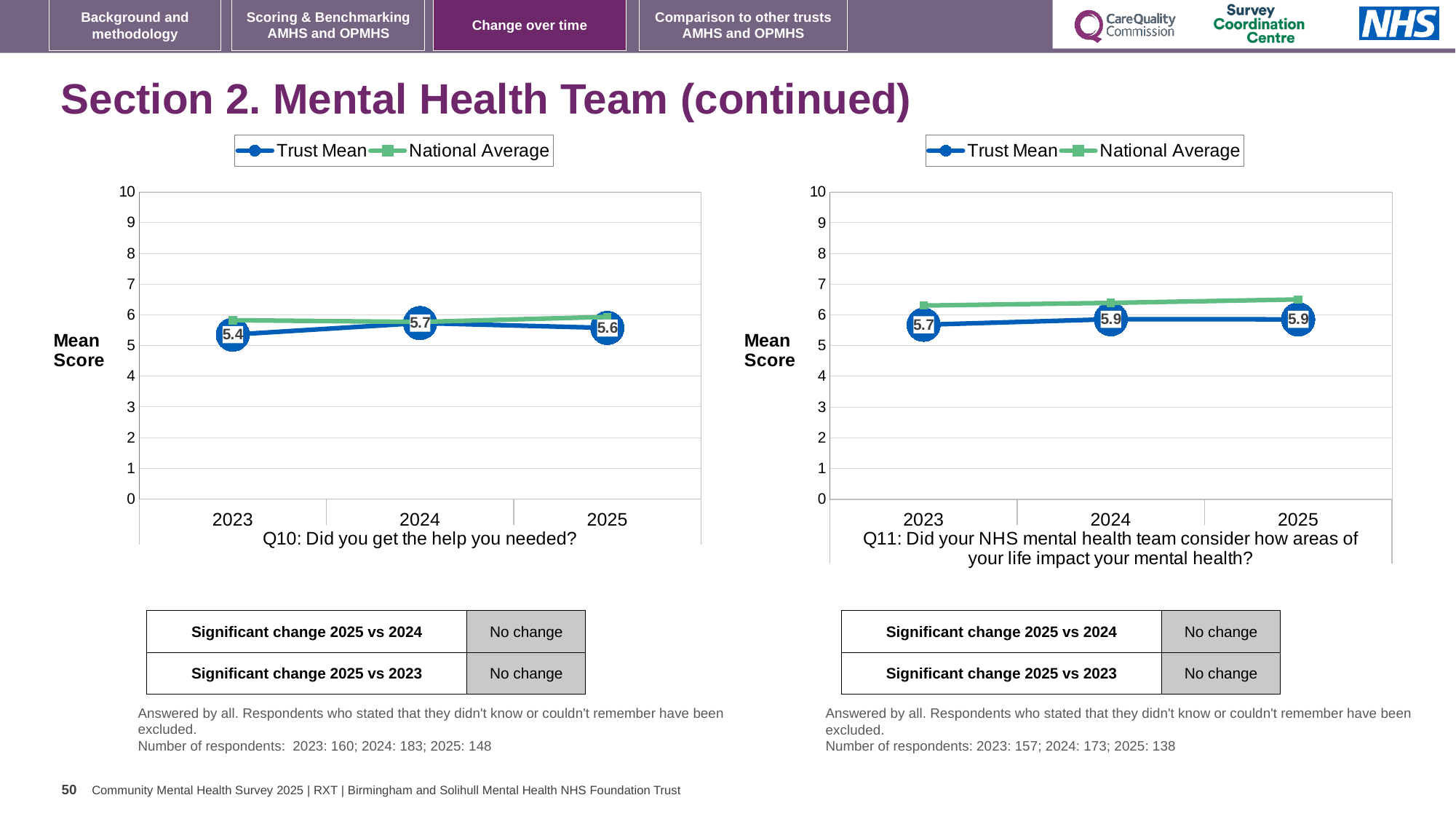
What type of chart is used for Q11? Line chart In the Q11 chart, which year has the lowest Trust Mean? 2023 In the Q10 chart, what is the Trust Mean for 2025? 5.6 In the Q11 chart, what is the Trust Mean for 2024? 5.9 In the Q10 chart, is the Trust Mean higher in 2023 or 2025? 2025 In the Q10 chart, which year has the highest Trust Mean? 2024 How many years are plotted on the x axis of the Q11 chart? 3 In the Q11 chart, what is the difference between the Trust Mean for 2025 and 2023? 0.2 In the Q11 chart, is the National Average for 2025 greater or less than 6? greater In the Q10 chart, what is the Trust Mean for 2023? 5.4 In the Q10 chart, what is the difference between the Trust Mean for 2024 and 2023? 0.3 How many series does the legend of the Q10 chart list? 2